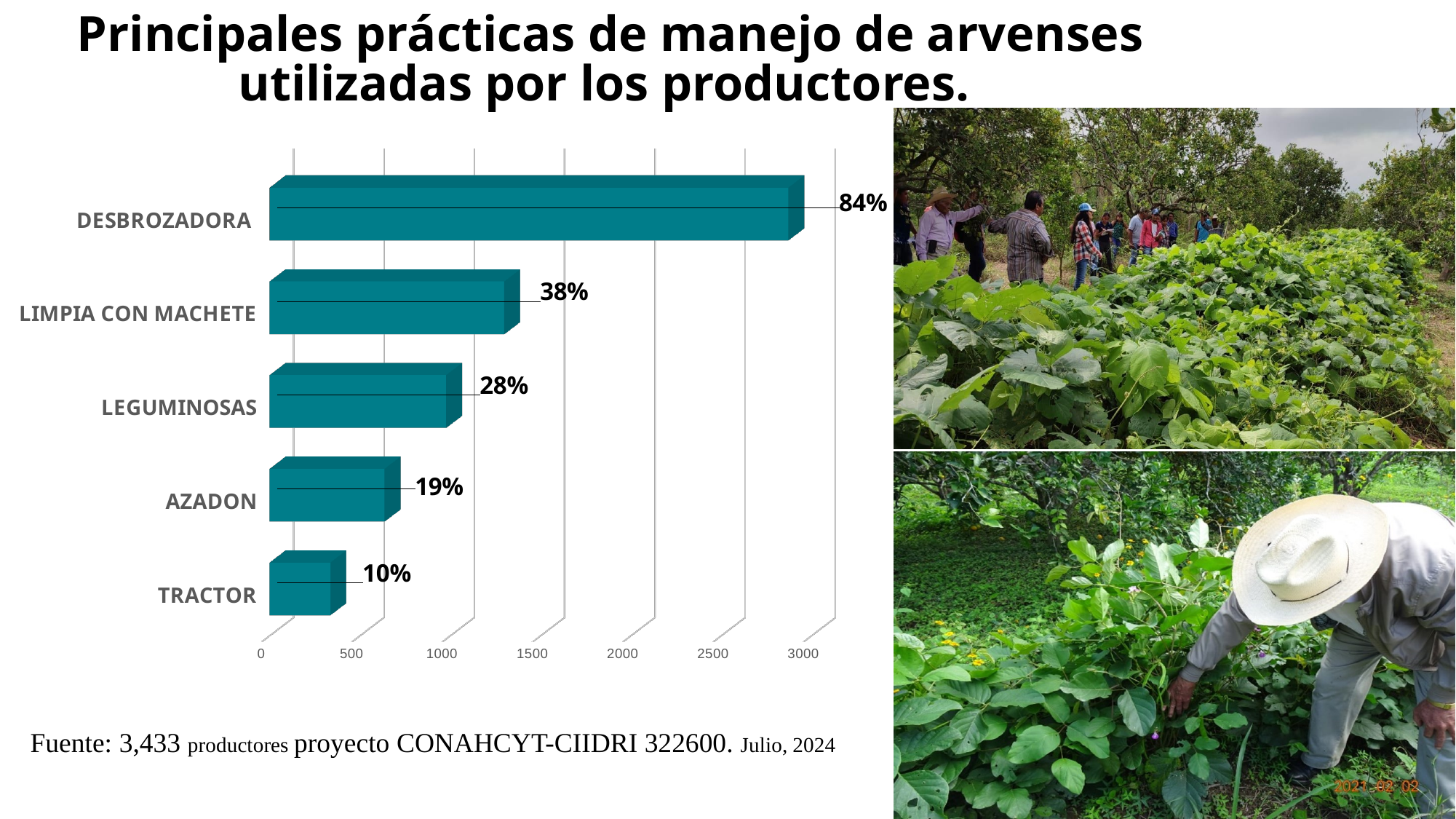
Which has a larger value, AZADON or LEGUMINOSAS? LEGUMINOSAS What kind of chart is shown on the slide? Bar chart How many practices (categories) are shown in the chart? 5 Which practice has the highest value in the chart? DESBROZADORA What is the difference in percentage points between the labels for DESBROZADORA and LIMPIA CON MACHETE? 46 What is the data label shown for LIMPIA CON MACHETE? 38% What is the data label shown for LEGUMINOSAS? 28% Is the bar for DESBROZADORA greater or less than 2500 on the horizontal axis? greater Which practice has the lowest value in the chart? TRACTOR Is the bar for TRACTOR greater or less than 500 on the horizontal axis? less What is the data label shown for DESBROZADORA? 84% What is the data label shown for TRACTOR? 10%